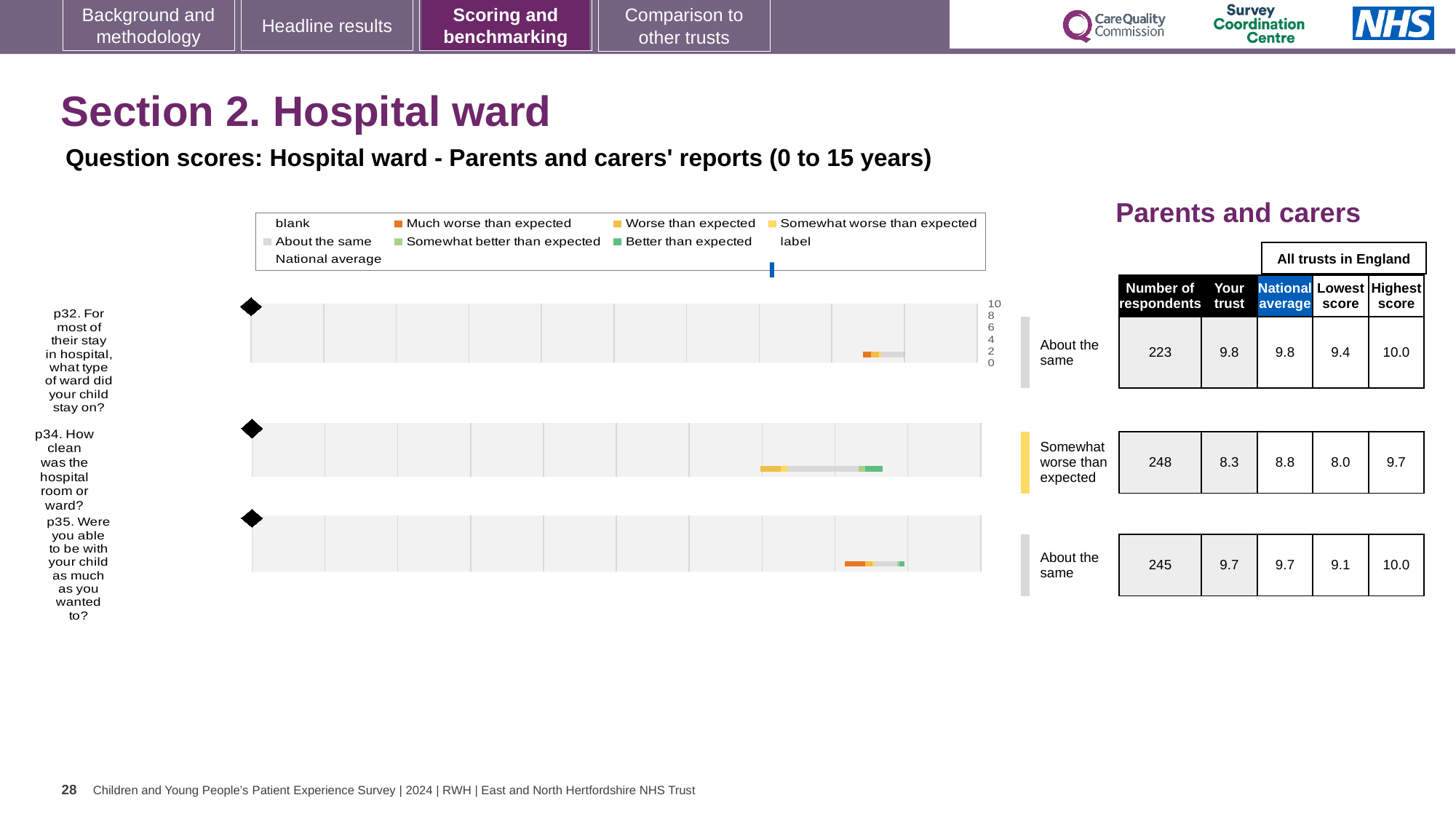
What benchmark category is shown for p34 (How clean was the hospital room or ward?)? Somewhat worse than expected For p34, what is the difference between the national average and the 'Your trust' score? 0.5 What is the 'Your trust' score for p34 (How clean was the hospital room or ward?)? 8.3 What is the highest score across all trusts in England for p34? 9.7 What colour does the legend use for 'Better than expected'? green Which question has the lowest 'Your trust' score? p34 Which question has the highest 'Your trust' score? p32 What is the national average score for p35 (Were you able to be with your child as much as you wanted to)? 9.7 How many respondents are listed for p32 (what type of ward did your child stay on)? 223 How many questions (p32, p34, p35) are plotted on this slide? 3 Which has the larger 'Your trust' score, p32 or p35? p32 What kind of chart is used to show the question scores on this slide? bar chart